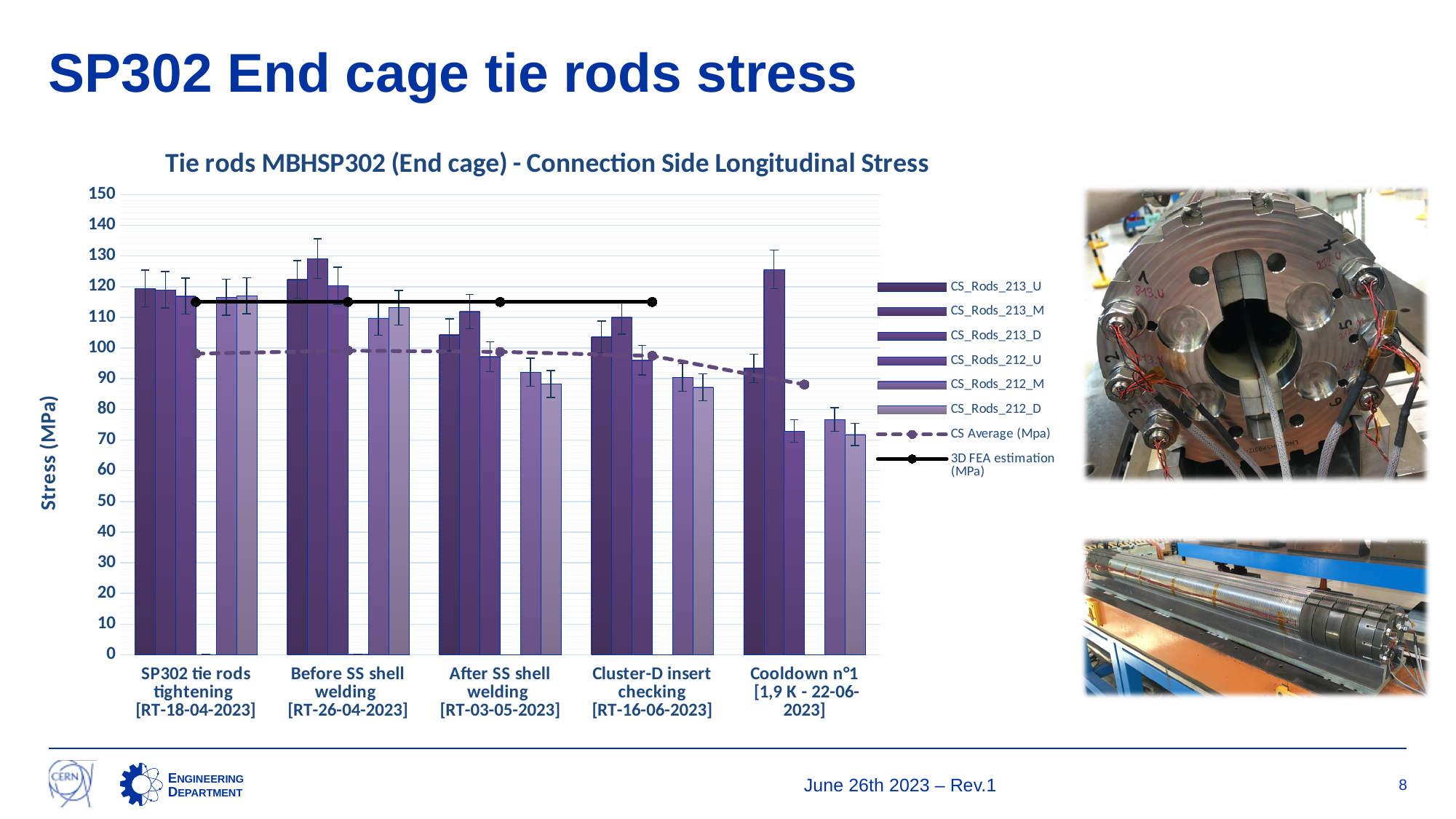
Is the 3D FEA estimation (MPa) line greater or less than 110? greater Is the value for CS_Rods_212_D in the Cooldown n°1 category greater or less than 80? less What kind of chart is shown on the slide? combination bar and line chart Is the value for CS_Rods_213_M in the Cooldown n°1 category greater or less than 120? greater Does the CS Average (Mpa) line rise or fall from the first category to the last category? fall What is the title of the chart? Tie rods MBHSP302 (End cage) - Connection Side Longitudinal Stress In the Cooldown n°1 category, which is larger: the value for CS_Rods_213_M or the value for CS_Rods_213_D? CS_Rods_213_M How many series does the chart legend list? 8 How many categories are shown along the x axis of the chart? 5 What is the label of the vertical axis of the chart? Stress (MPa) Which category has the lowest CS Average (Mpa) value? Cooldown n°1 [1,9 K - 22-06-2023]